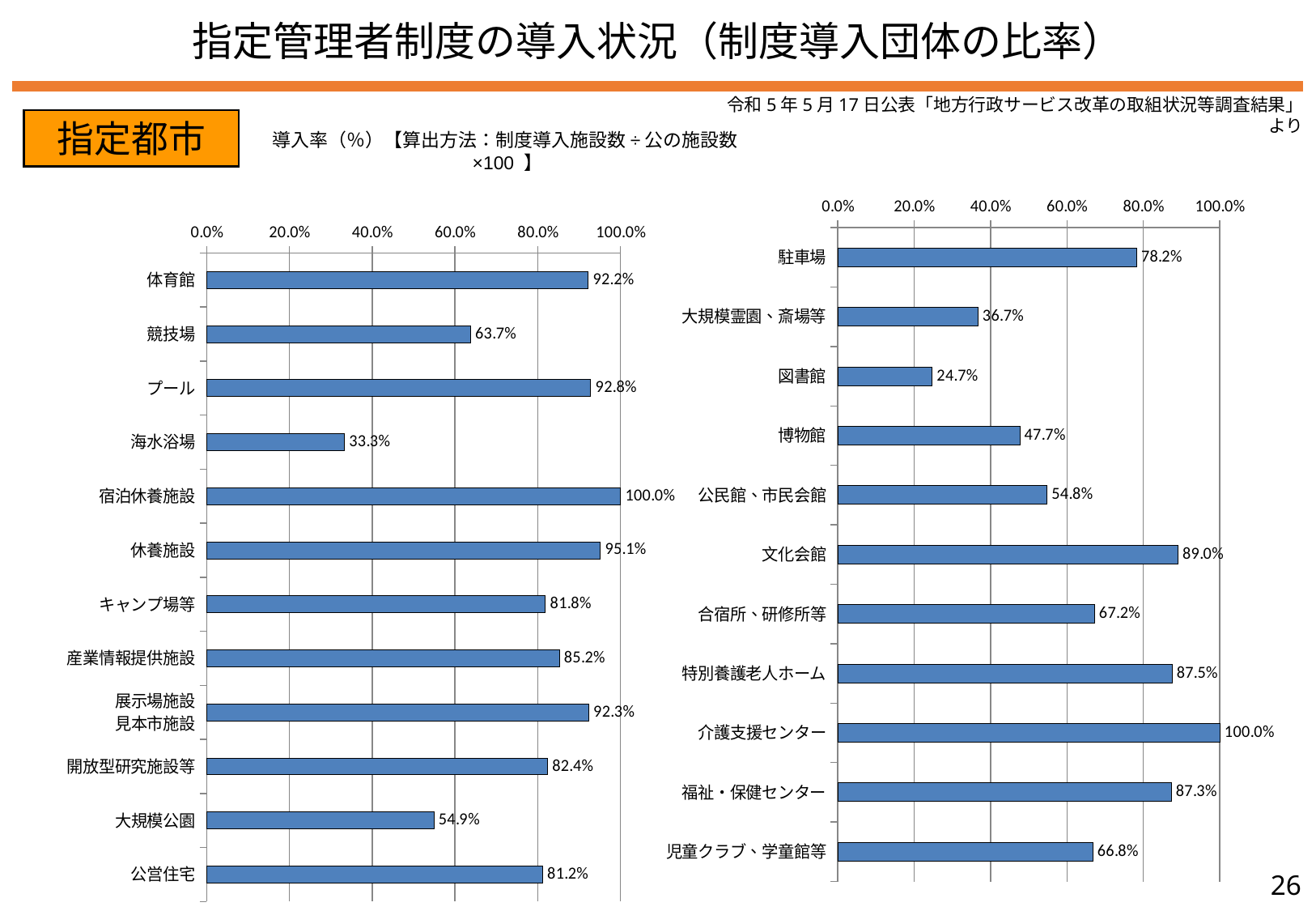
In the right chart, which category has the lowest value? 図書館 What kind of chart is the left chart? Bar chart In the right chart, what is the value for 図書館? 24.7% In the right chart, what is the difference between the values for 文化会館 and 合宿所、研修所等? 21.8% In the left chart, which category has the lowest value? 海水浴場 In the right chart, how many categories are shown? 11 In the right chart, which is larger, the value for 駐車場 or the value for 博物館? 駐車場 In the left chart, what is the difference between the values for プール and 競技場? 29.1% In the right chart, which category has the highest value? 介護支援センター In the left chart, which category has the highest value? 宿泊休養施設 In the left chart, what is the value for 海水浴場? 33.3% In the left chart, how many categories are shown? 12